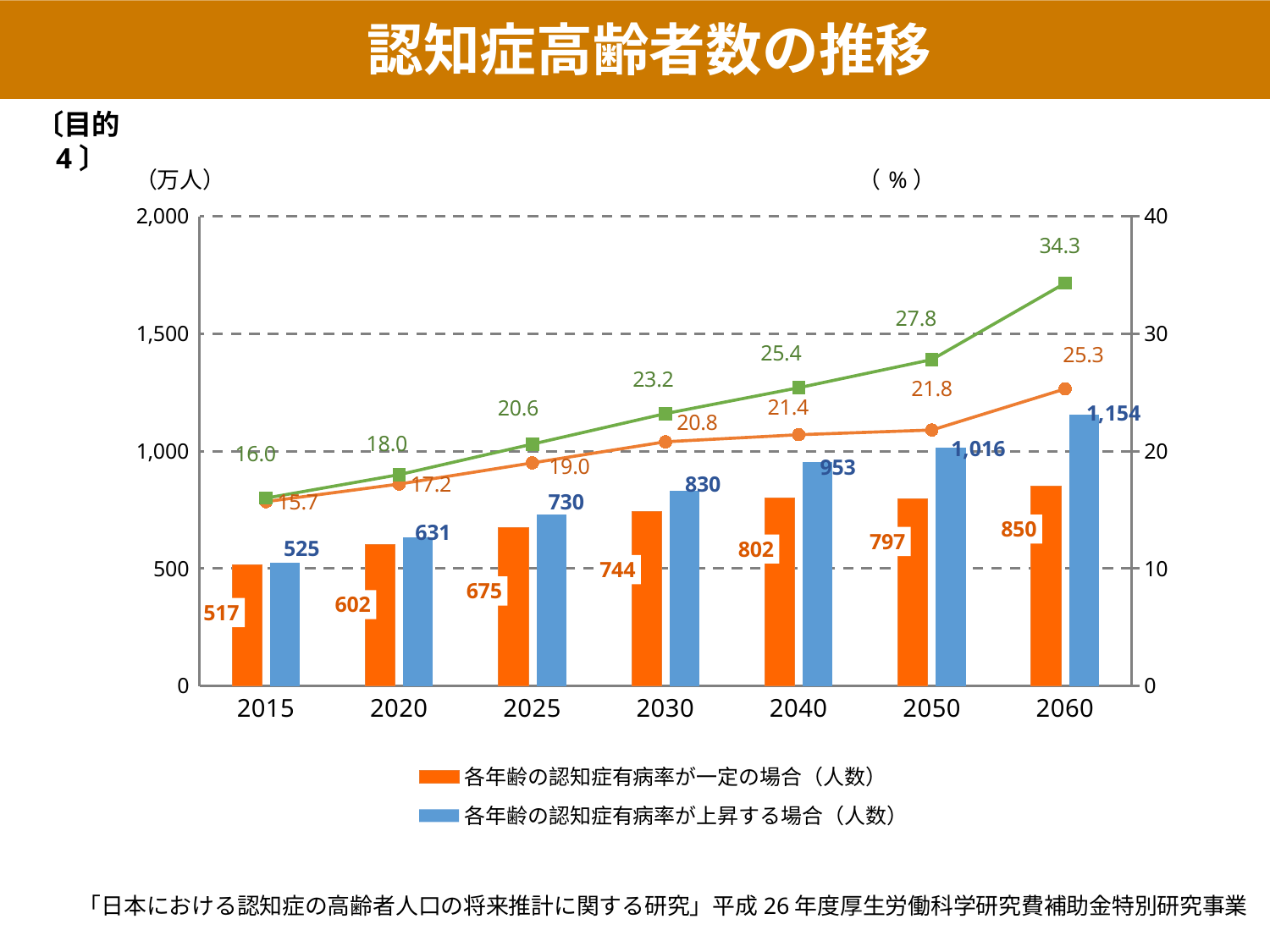
Which is larger: the orange bar for 2040 or the orange bar for 2050? 2040 What is the value of the orange bar (各年齢の認知症有病率が一定の場合) for 2030? 744 What kind of chart is shown on the slide? Bar chart combined with line chart Do the blue bars rise or fall from 2015 to 2060? rise What is the value of the blue bar (各年齢の認知症有病率が上昇する場合) for 2060? 1,154 Is the blue bar for 2050 greater or less than 1,000? greater What is the value of the green line's data label for 2060? 34.3 How many years are shown on the x axis? 7 What is the difference between the blue bar and the orange bar in 2040? 151 How many series does the legend list? 2 In which year is the orange bar (各年齢の認知症有病率が一定の場合) lowest? 2015 In which year is the blue bar (各年齢の認知症有病率が上昇する場合) highest? 2060